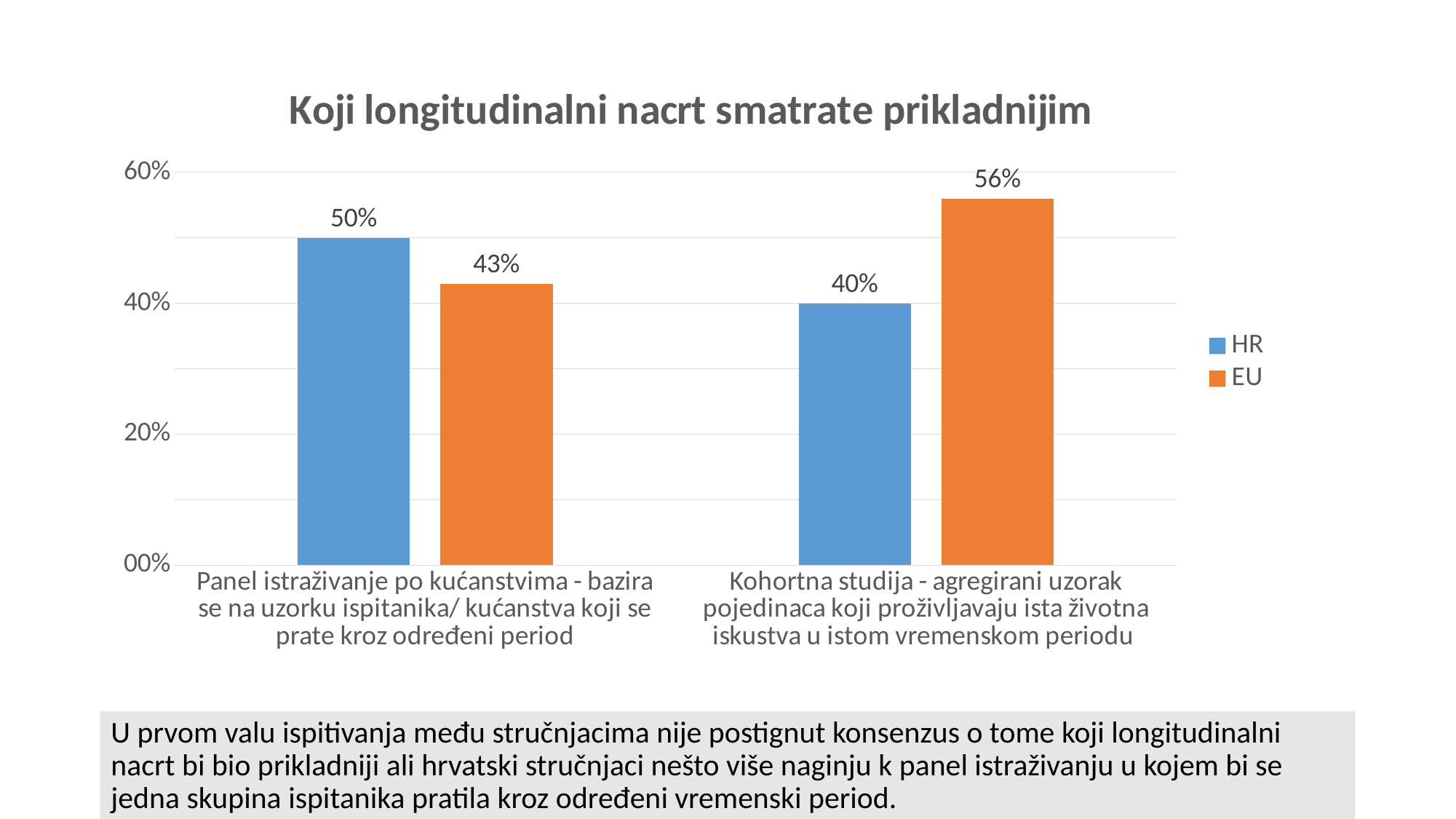
What is the difference between the EU and HR values for the cohort study (Kohortna studija)? 16% What is the title of the chart? Koji longitudinalni nacrt smatrate prikladnijim Which bar has the highest value in the chart? EU, Kohortna studija (56%) What is the HR value for the cohort study (Kohortna studija)? 40% For the panel study (Panel istraživanje po kućanstvima), which is larger, the HR value or the EU value? HR What is the difference between the HR and EU values for the panel study (Panel istraživanje po kućanstvima)? 7% What is the EU value for the cohort study (Kohortna studija)? 56% Which bar has the lowest value in the chart? HR, Kohortna studija (40%) How many series does the legend list? 2 What is the EU value for the panel study (Panel istraživanje po kućanstvima)? 43% What is the HR value for the panel study (Panel istraživanje po kućanstvima)? 50% What kind of chart is shown on the slide? Bar chart